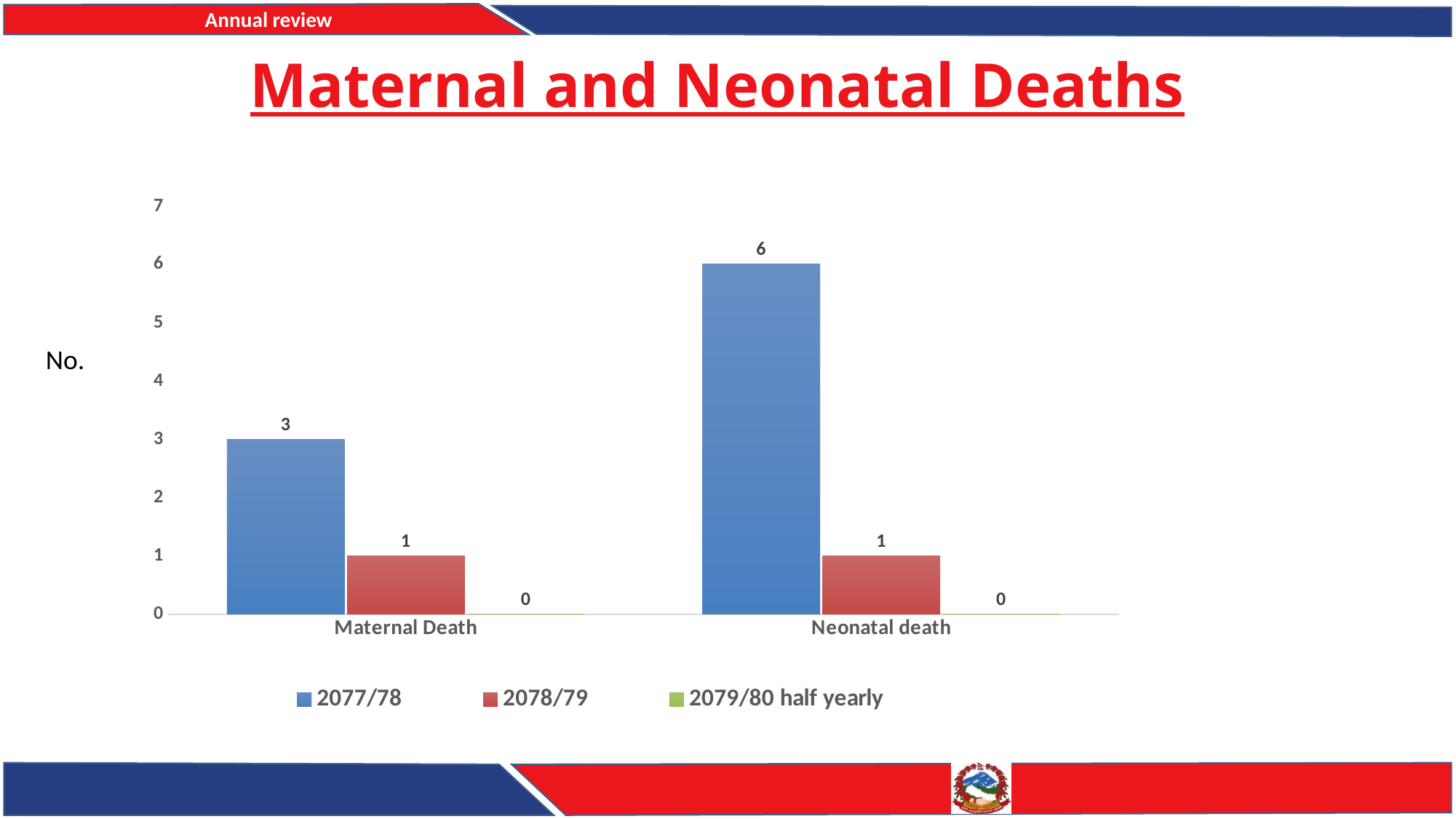
What is the value for Maternal Death in 2077/78? 3 What is the difference between the 2077/78 and 2078/79 values for Neonatal death? 5 Which category has the highest value in the 2077/78 series? Neonatal death What is the title of the slide's chart? Maternal and Neonatal Deaths What is the difference between the 2077/78 values for Neonatal death and Maternal Death? 3 How many categories are shown on the x axis? 2 What is the value for Neonatal death in 2079/80 half yearly? 0 What kind of chart is shown on the slide? Bar chart Which is larger for Maternal Death: the 2077/78 value or the 2078/79 value? 2077/78 How many series does the legend list? 3 What is the value for Maternal Death in 2078/79? 1 What is the value for Neonatal death in 2077/78? 6